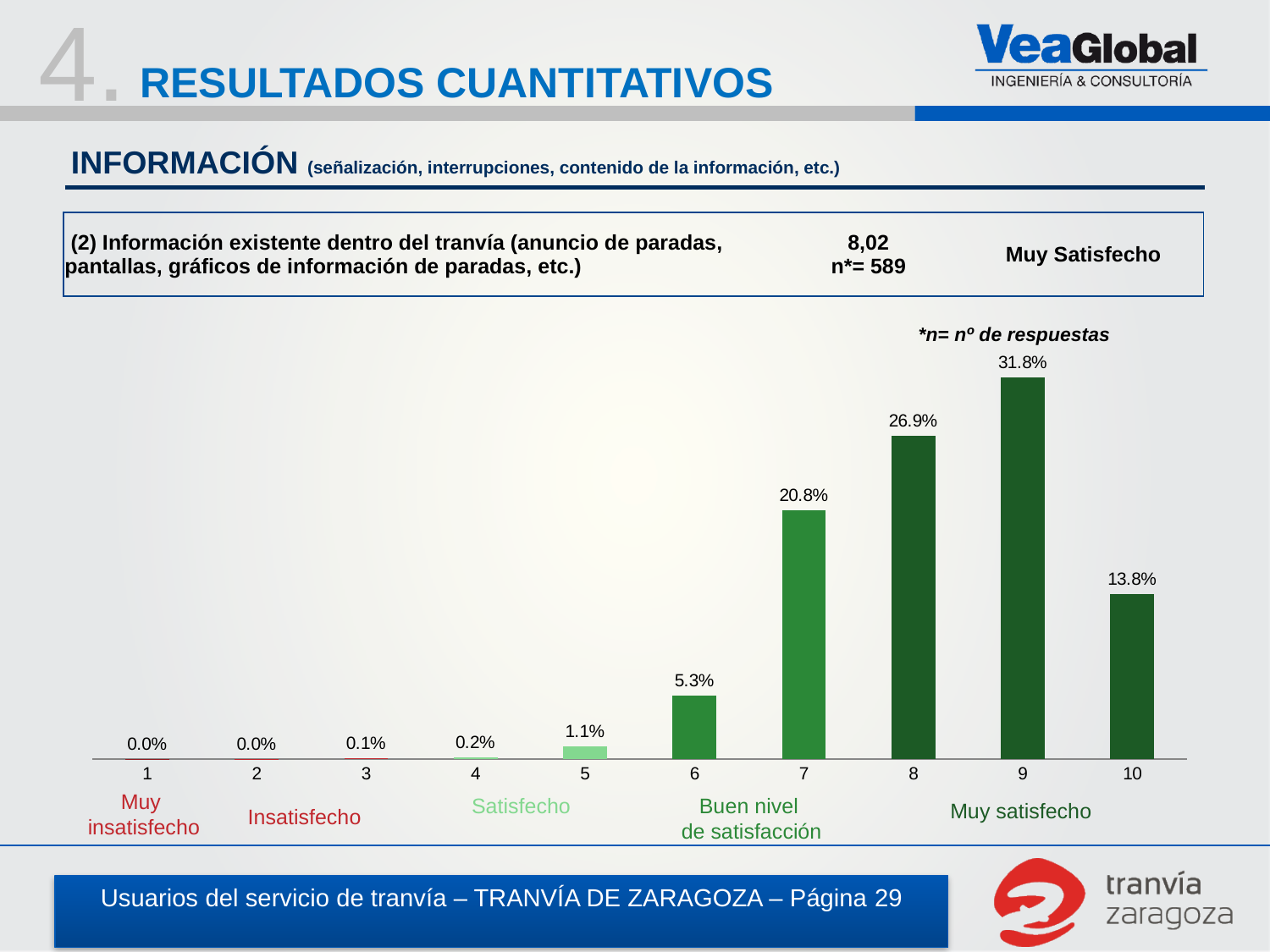
Which score received the highest percentage of responses? 9 What kind of chart is shown on the slide? bar chart Which has a larger value, score 8 or score 10? 8 What percentage of responses gave a score of 7? 20.8% What is the difference in percentage points between the bars for score 9 and score 8? 4.9 What percentage of responses gave a score of 5? 1.1% What is the combined percentage for scores 8, 9 and 10? 72.5% How many score categories are shown on the x axis? 10 What percentage of responses gave a score of 9? 31.8% What percentage of responses gave a score of 10? 13.8% What is the difference in percentage points between the bars for score 7 and score 6? 15.5 Which scores are labelled 'Muy insatisfecho' below the x axis? 1